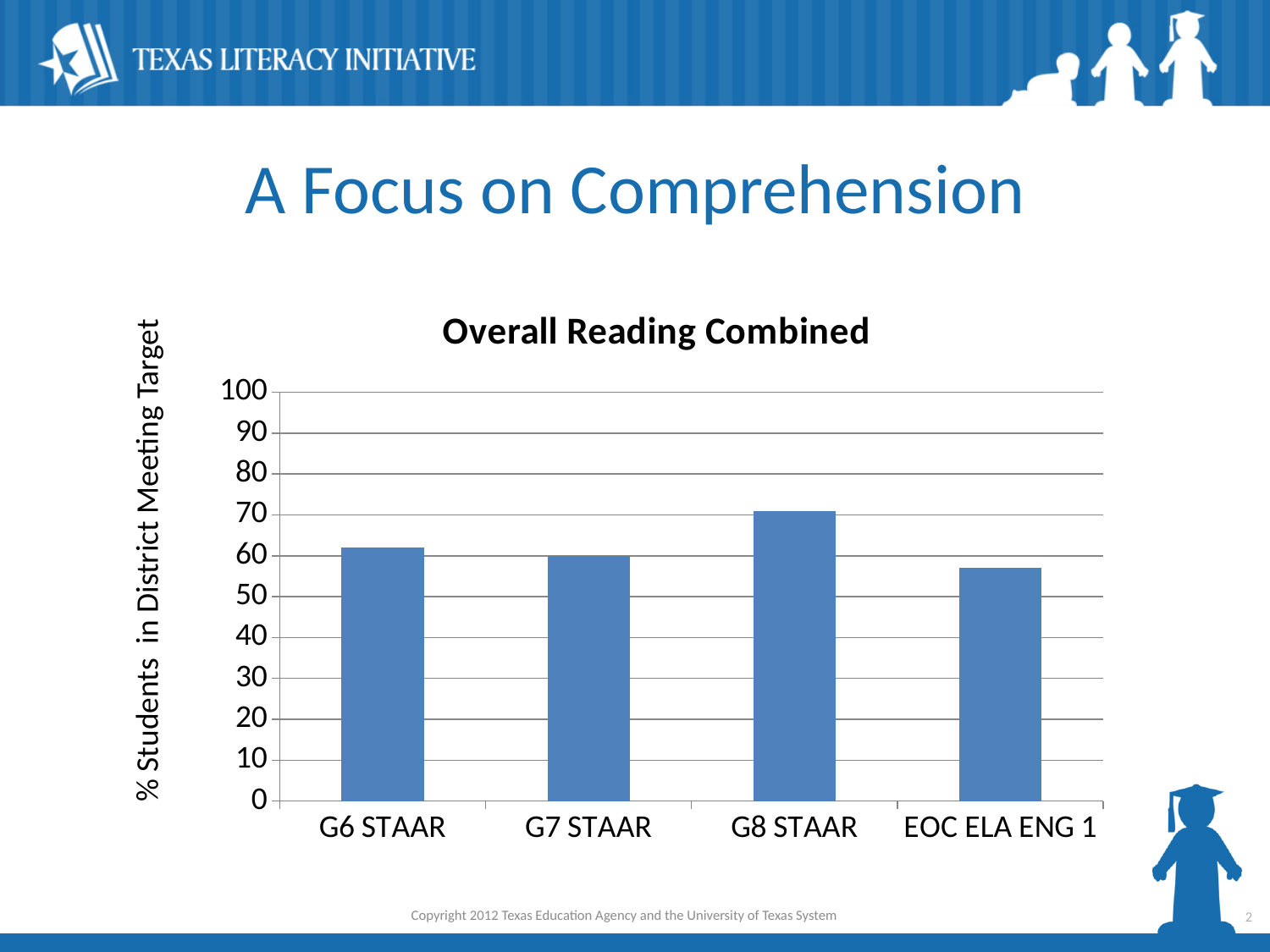
Which category has the highest value in the chart? G8 STAAR How many categories are shown on the x axis of the chart? 4 What is the value for G7 STAAR? 60 Is the value for G8 STAAR greater or less than 60? greater Is the value for EOC ELA ENG 1 greater or less than 60? less What type of chart is shown on the slide? bar chart Which is larger, the value for G8 STAAR or the value for EOC ELA ENG 1? G8 STAAR What is the title of the chart? Overall Reading Combined Which category has the lowest value in the chart? EOC ELA ENG 1 Is the value for G6 STAAR greater or less than 70? less Which is larger, the value for G6 STAAR or the value for EOC ELA ENG 1? G6 STAAR What is the label on the vertical axis of the chart? % Students in District Meeting Target